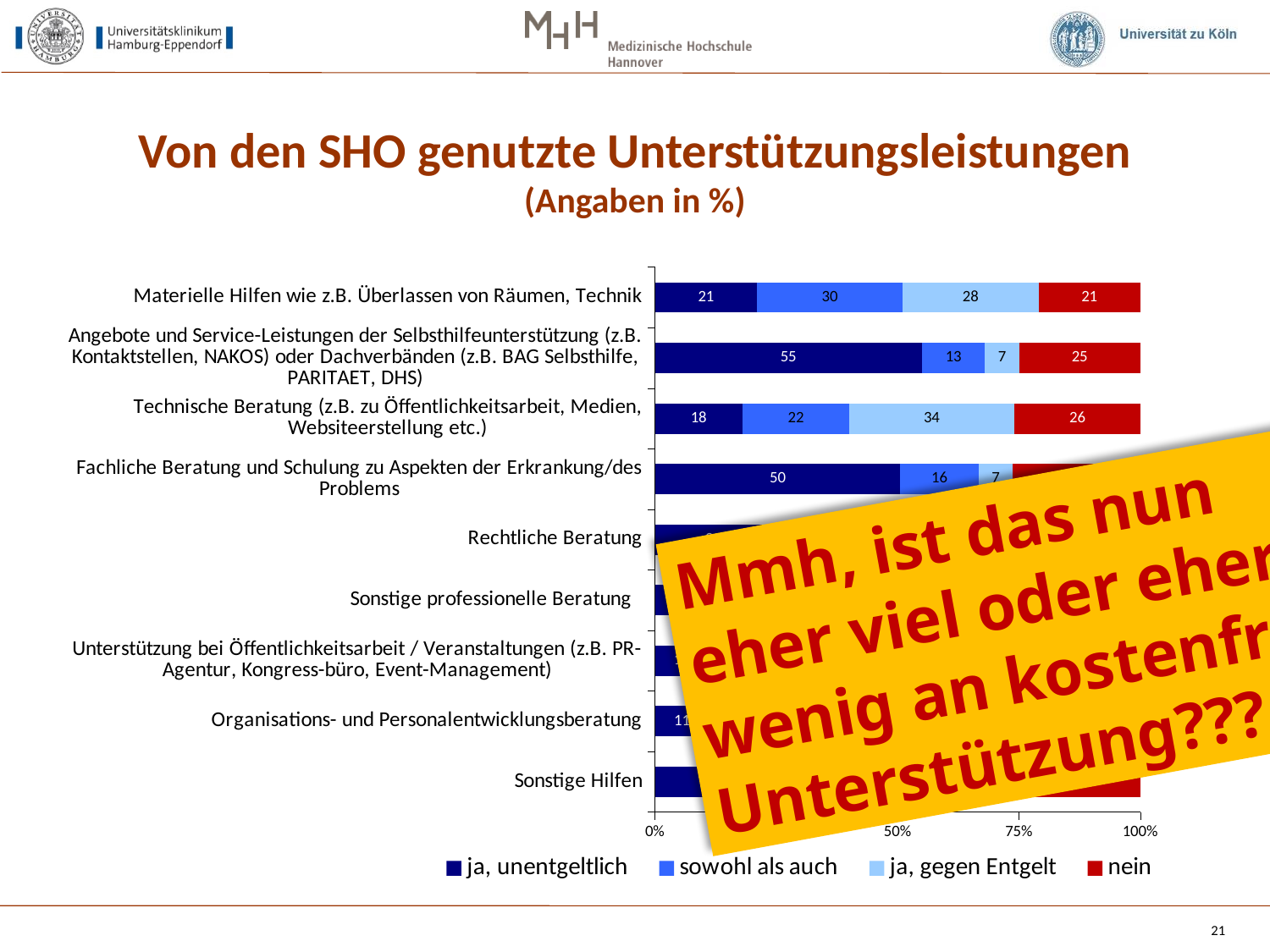
What is the value for 'ja, unentgeltlich' for 'Angebote und Service-Leistungen der Selbsthilfeunterstützung (z.B. Kontaktstellen, NAKOS) oder Dachverbänden (z.B. BAG Selbsthilfe, PARITAET, DHS)'? 55 Which series is shown in red in the chart? nein How many categories are listed on the vertical axis of the chart? 9 What kind of chart is shown on the slide? stacked bar chart What is the title of the chart on the slide? Von den SHO genutzte Unterstützungsleistungen (Angaben in %) What is the value for 'ja, gegen Entgelt' for 'Technische Beratung (z.B. zu Öffentlichkeitsarbeit, Medien, Websiteerstellung etc.)'? 34 What is the value for 'sowohl als auch' for 'Fachliche Beratung und Schulung zu Aspekten der Erkrankung/des Problems'? 16 What is the difference between the 'ja, unentgeltlich' values for 'Angebote und Service-Leistungen der Selbsthilfeunterstützung' and 'Materielle Hilfen wie z.B. Überlassen von Räumen, Technik'? 34 Which is larger for 'Materielle Hilfen wie z.B. Überlassen von Räumen, Technik': the 'sowohl als auch' value or the 'ja, gegen Entgelt' value? sowohl als auch What is the value for 'ja, unentgeltlich' for 'Materielle Hilfen wie z.B. Überlassen von Räumen, Technik'? 21 How many series does the legend list? 4 What is the value for 'nein' for 'Technische Beratung (z.B. zu Öffentlichkeitsarbeit, Medien, Websiteerstellung etc.)'? 26